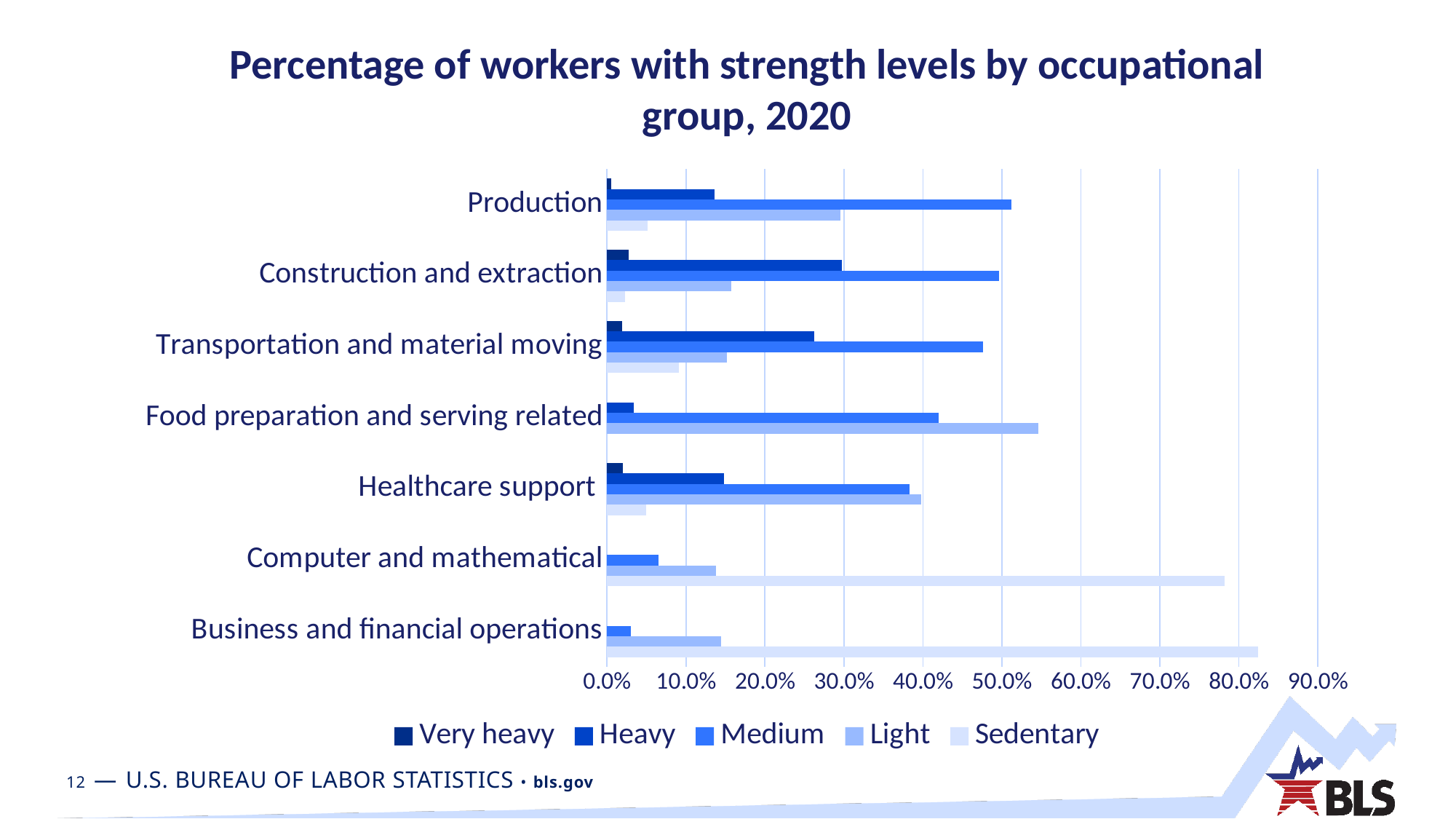
How many occupational groups are shown on the chart? 7 Is the Sedentary value for Computer and mathematical greater or less than 70.0%? greater Which occupational group has the highest Heavy percentage? Construction and extraction What is the title of the chart? Percentage of workers with strength levels by occupational group, 2020 Is the Heavy value for Healthcare support greater or less than 20.0%? less Which occupational group has the highest Sedentary percentage? Business and financial operations How many series does the legend list? 5 Which is larger: the Medium value for Transportation and material moving or the Medium value for Food preparation and serving related? Transportation and material moving Is the Heavy value for Construction and extraction greater or less than 20.0%? greater What kind of chart is shown on the slide? Bar chart Which occupational group has the lowest Medium percentage? Business and financial operations